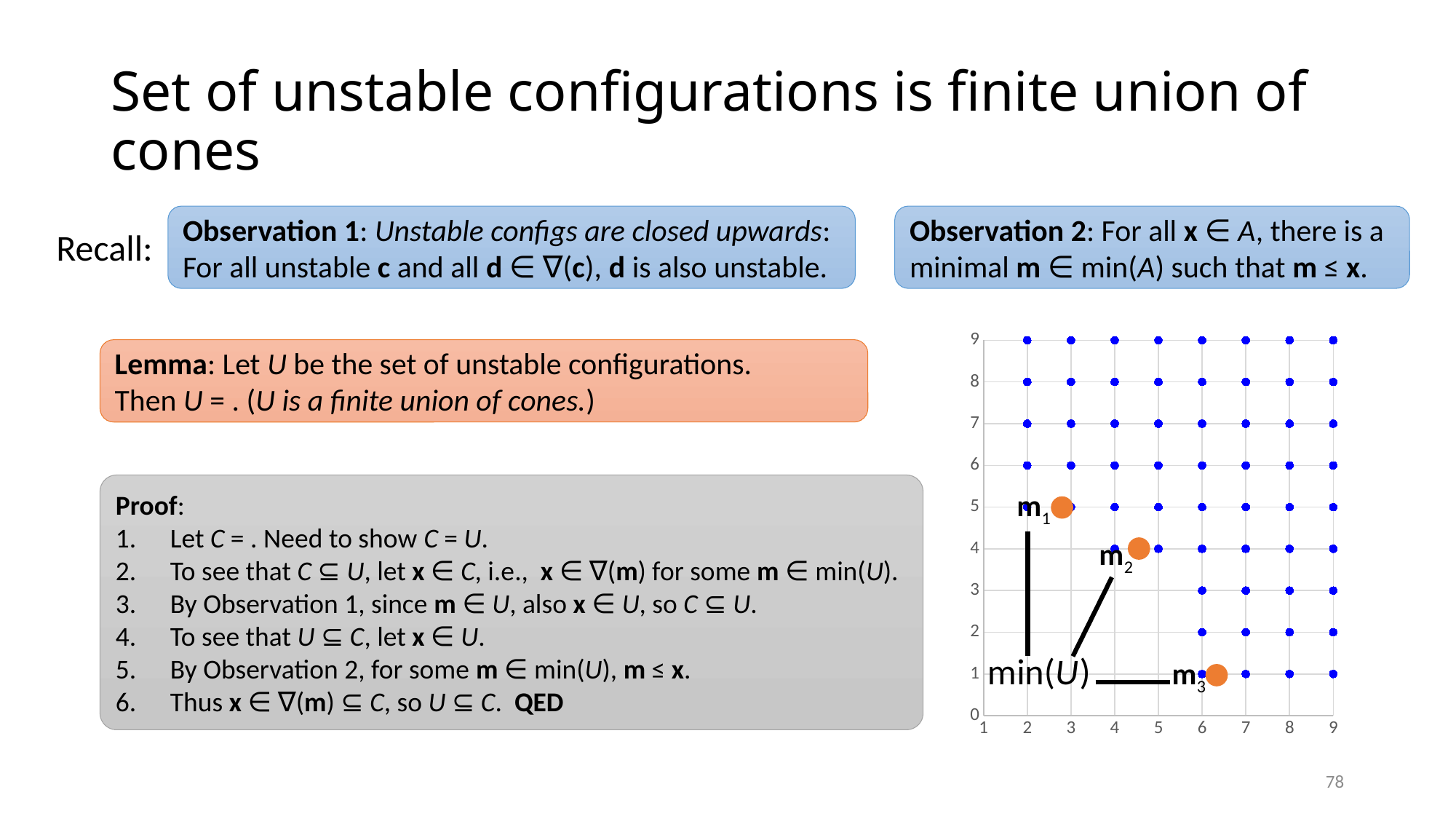
Which of the orange points, m1, m2 or m3, has the highest y-value? m1 Which of the orange points, m1, m2 or m3, is furthest to the right on the x axis? m3 Is the y-value of point m1 greater or less than 4? greater Is the y-value of point m3 greater or less than 2? less How many orange (labelled) points are plotted on the chart? 3 How many blue points are plotted in the top row of the chart (at y = 9)? 8 Which has the larger y-value, m2 or m3? m2 Is the x-value of point m2 greater or less than 3? greater Which of the orange points, m1, m2 or m3, has the lowest y-value? m3 What label is written next to the orange points on the chart? min(U) What kind of chart is shown on the right side of the slide? scatter chart What is the highest tick value shown on the y axis of the chart? 9